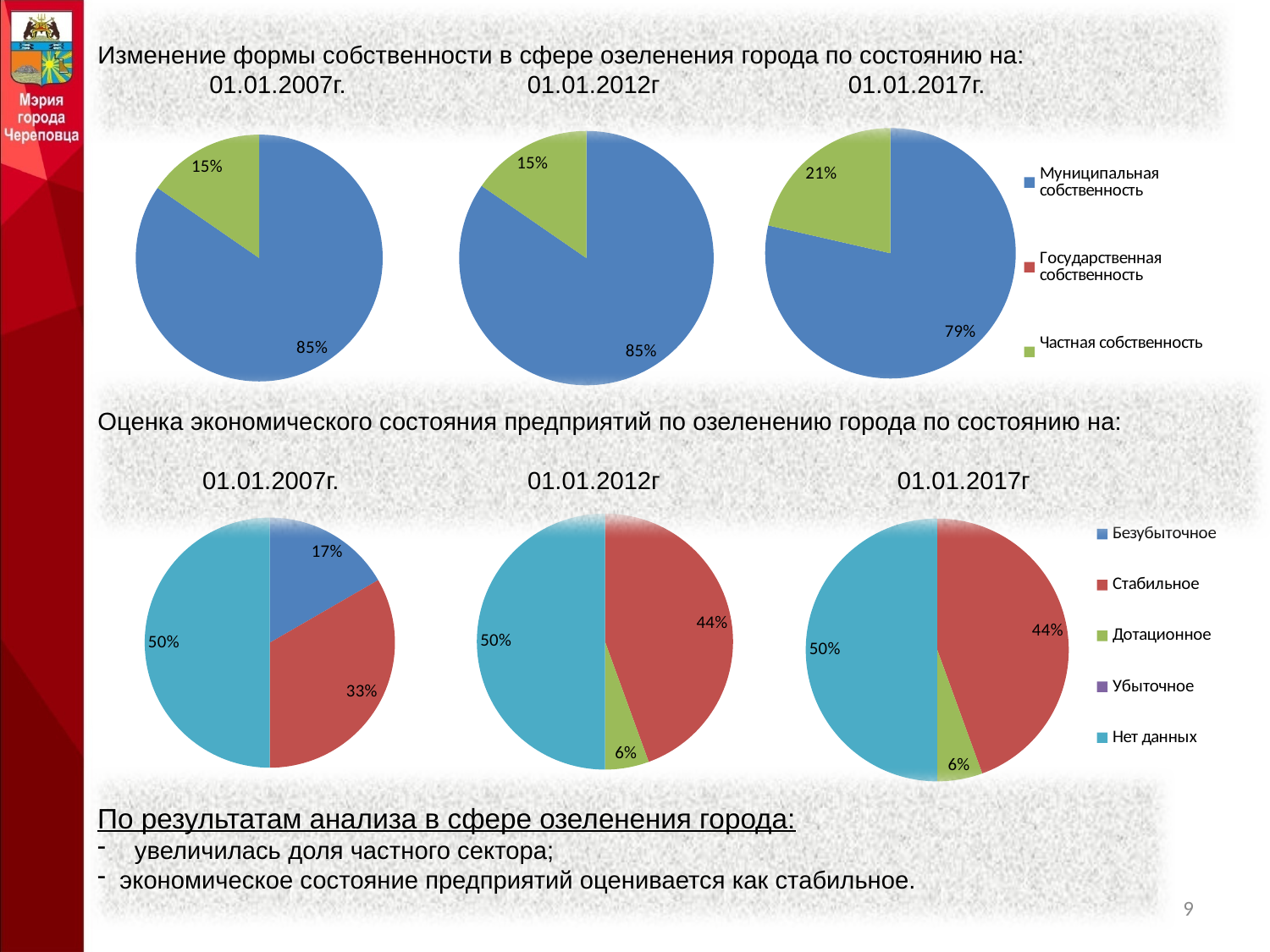
In the bottom-row pie chart for 01.01.2017г, which is larger: the Стабильное slice or the Нет данных slice? Нет данных In the bottom-row pie chart for 01.01.2007г., what share is labelled for the Безубыточное slice? 17% In the bottom-row pie chart for 01.01.2007г., which category has the largest share? Нет данных In the top-row pie chart for 01.01.2017г., what is the difference between the Муниципальная собственность share and the Частная собственность share? 58% How many entries does the legend of the bottom-row economic-state pie charts list? 5 What kind of chart is used in the bottom row for 01.01.2012г? Pie chart In the top-row pie chart for 01.01.2012г., what is the share of the Частная собственность slice? 15% In the bottom-row pie chart for 01.01.2007г., what is the difference between the Нет данных share and the Стабильное share? 17% In the bottom-row pie chart for 01.01.2012г, what share does the Дотационное slice have? 6% In the top-row pie chart for 01.01.2017г., what share does the Частная собственность slice have? 21% How many entries does the legend of the top-row ownership pie charts list? 3 In the top-row pie chart for 01.01.2007г., what share is labelled for the Муниципальная собственность slice? 85%